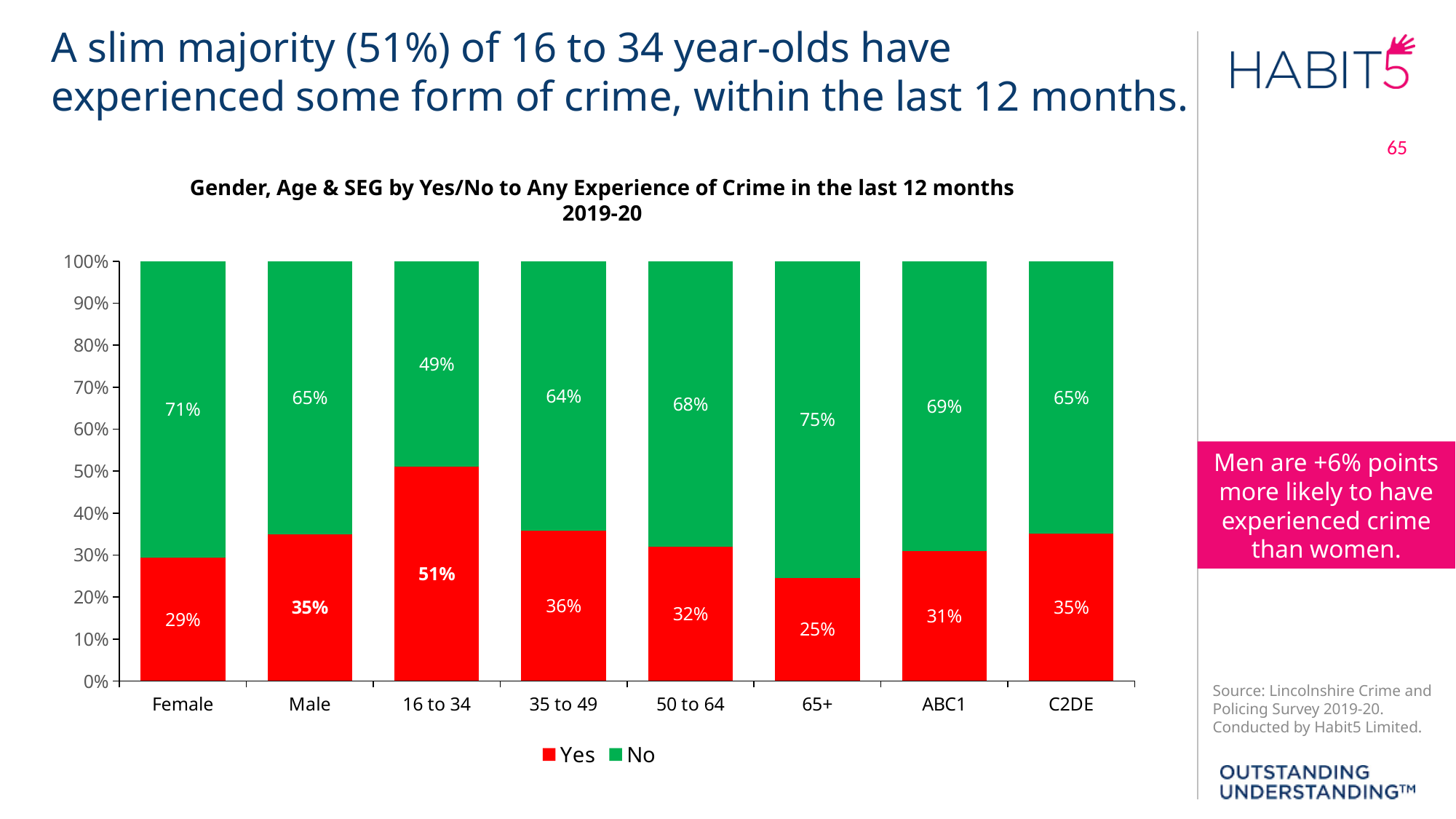
How many categories are shown on the x axis? 8 What kind of chart is shown? Stacked bar chart Which has a larger No value, ABC1 or C2DE? ABC1 How many series does the legend list? 2 What is the Yes value for Female? 29% What is the Yes value for 16 to 34? 51% What colour represents the Yes series? Red Which category has the highest Yes value? 16 to 34 What is the No value for 65+? 75% What is the total of the stacked bar for 50 to 64? 100% Which category has the lowest Yes value? 65+ What is the difference between the Yes values for Male and Female? 6%